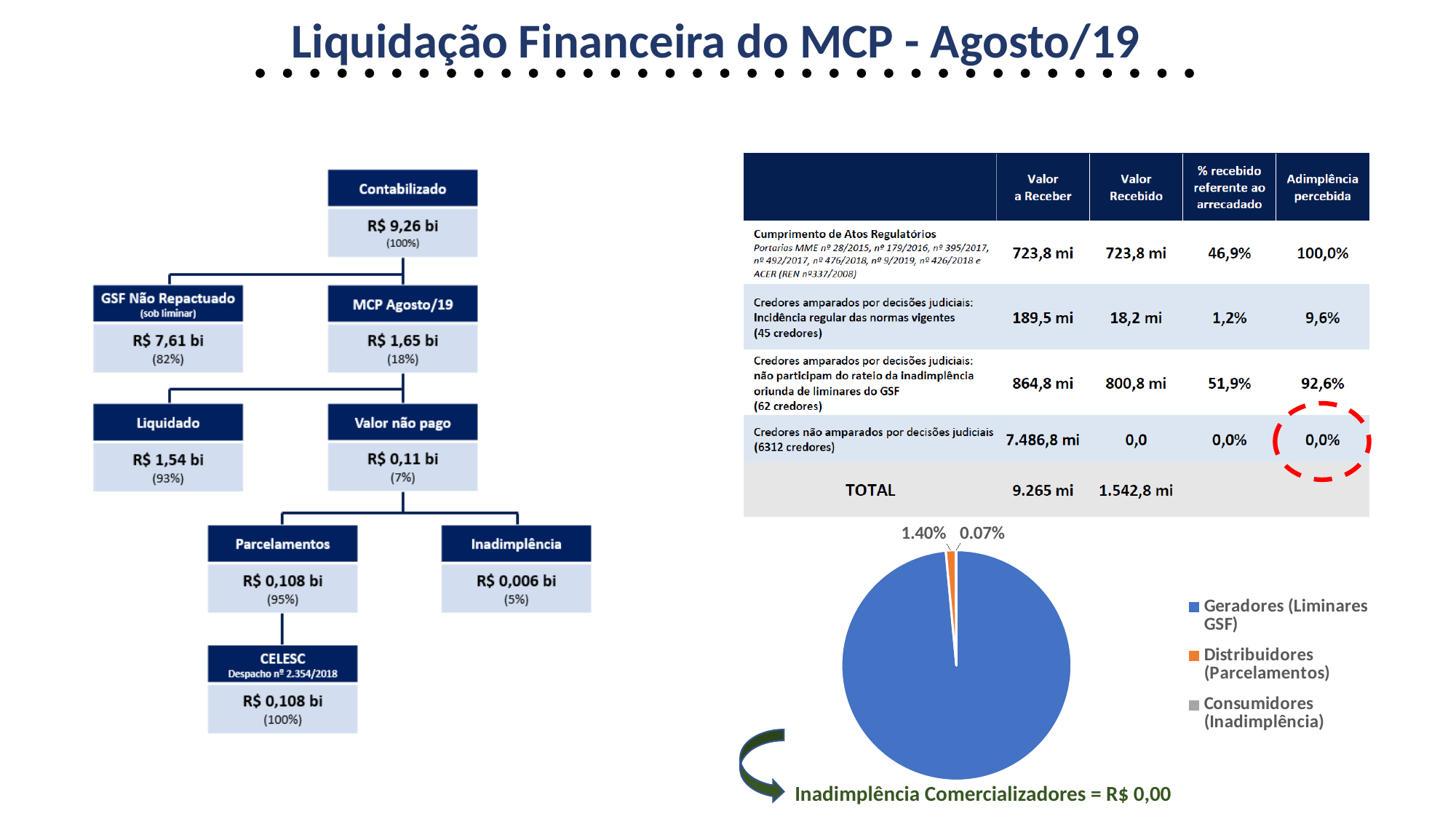
In the pie chart, which is larger: the slice for Distribuidores (Parcelamentos) or the slice for Consumidores (Inadimplência)? Distribuidores (Parcelamentos) In the pie chart, which colour represents Distribuidores (Parcelamentos)? orange In the pie chart, what percentage is shown for Distribuidores (Parcelamentos)? 1.40% How many categories does the legend of the pie chart list? 3 In the pie chart, which category has the largest slice? Geradores (Liminares GSF) In the pie chart, which colour represents Geradores (Liminares GSF)? blue In the pie chart, which category has the smallest slice? Consumidores (Inadimplência) In the pie chart, what percentage is shown for Consumidores (Inadimplência)? 0.07% In the pie chart, what is the difference between the Distribuidores (Parcelamentos) share and the Consumidores (Inadimplência) share? 1.33% What kind of chart is shown at the bottom right of the slide? pie chart